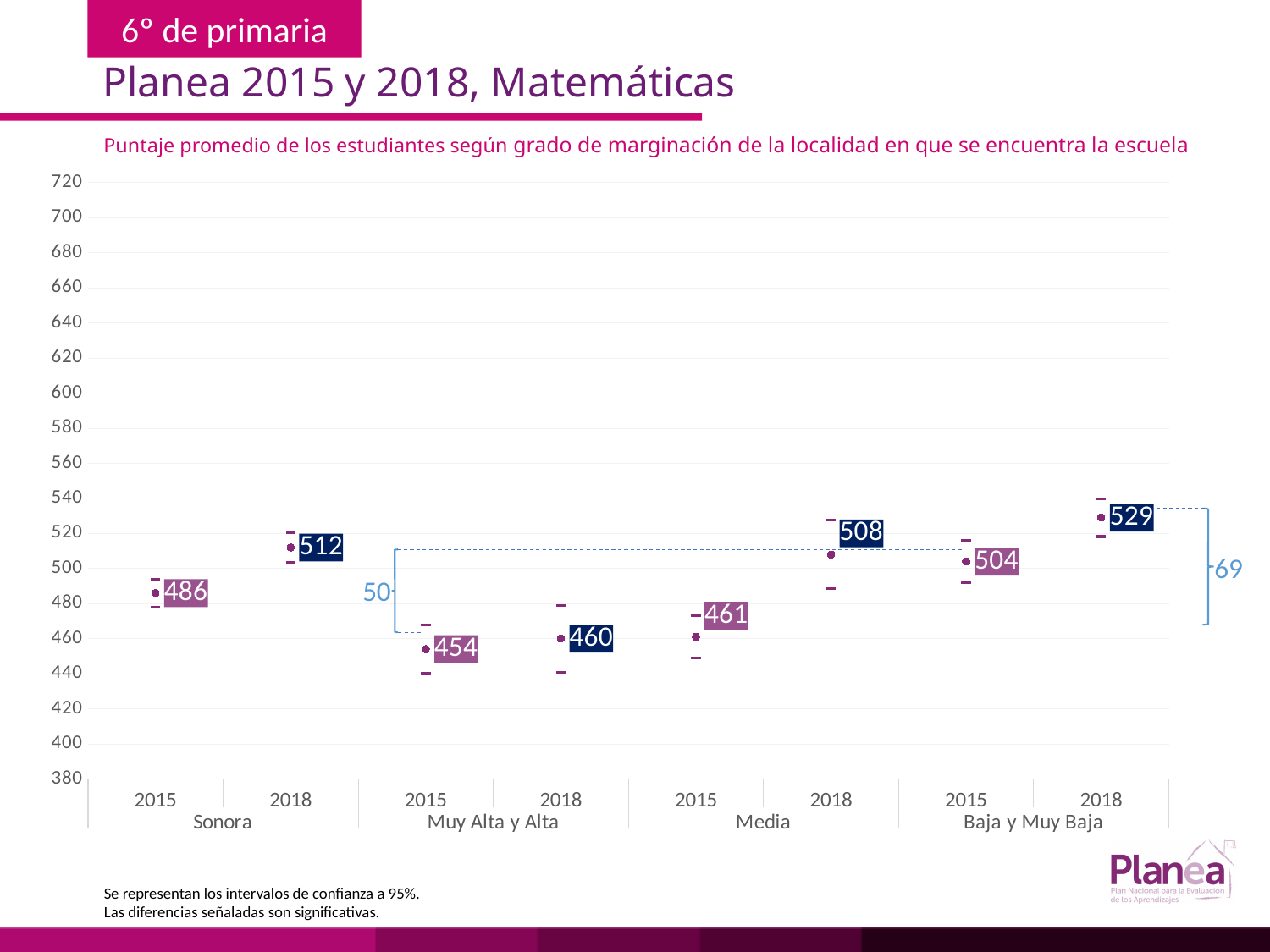
What is the average score for Sonora in 2018? 512 What is the average score for Sonora in 2015? 486 What is the average score for the Baja y Muy Baja marginación group in 2018? 529 What difference is annotated between the Baja y Muy Baja and Muy Alta y Alta groups in 2018? 69 What is the average score for the Muy Alta y Alta marginación group in 2015? 454 Which group and year has the lowest average score on the chart? Muy Alta y Alta, 2015 (454) What is the difference between the 2018 and 2015 scores for the Media group? 47 Which is larger, the 2015 score for Sonora or the 2015 score for Baja y Muy Baja? Baja y Muy Baja (504) How many data points (group-year combinations) are plotted on the chart? 8 What is the average score for the Media marginación group in 2018? 508 Does the score for each marginación group rise or fall from 2015 to 2018? Rise Which group and year has the highest average score on the chart? Baja y Muy Baja, 2018 (529)